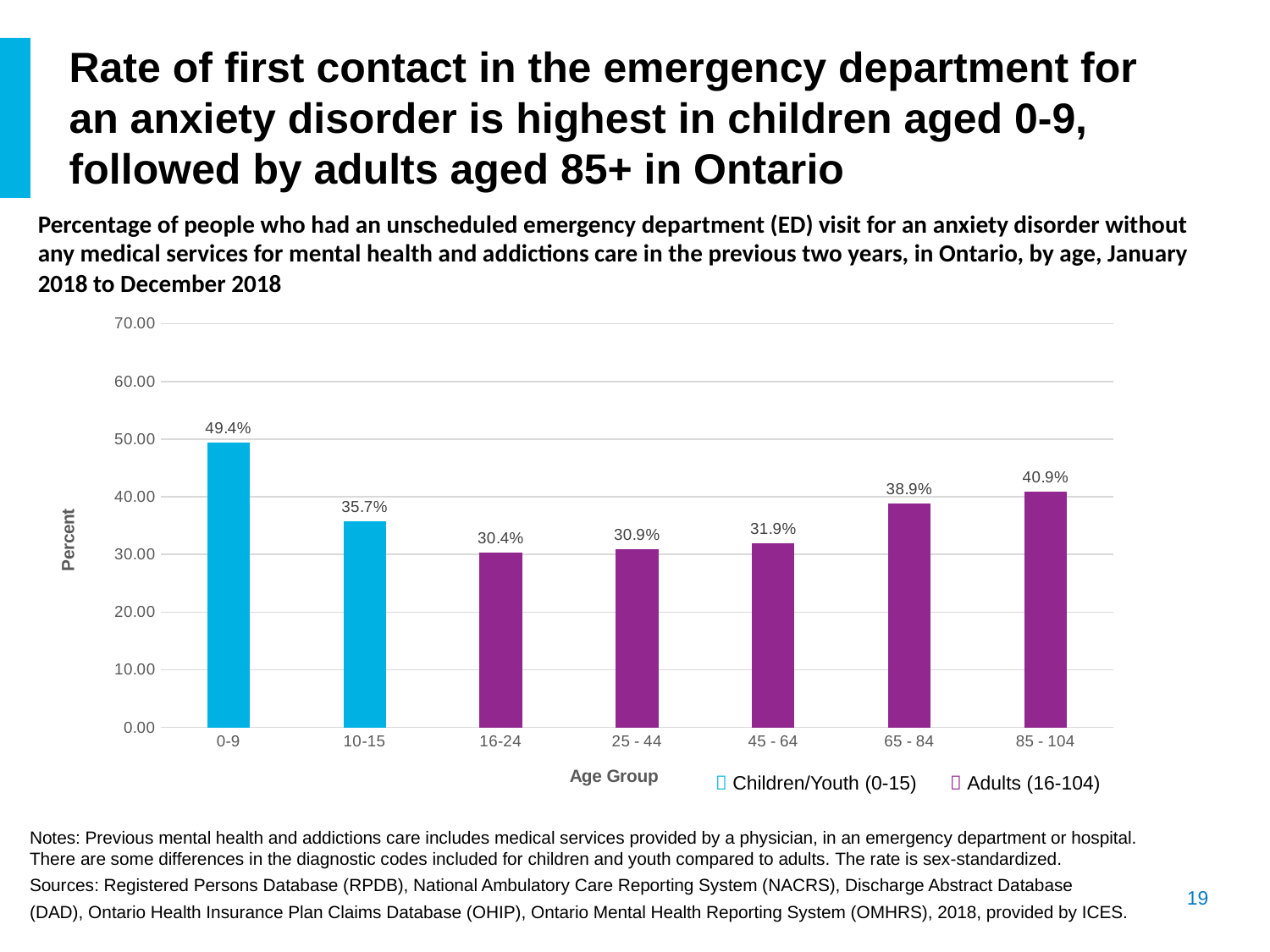
What is the difference between the values for the 0-9 and 85 - 104 age groups? 8.5 percentage points Which age group has the lowest value? 16-24 What is the label of the y axis? Percent Which is larger, the value for 10-15 or the value for 45 - 64? 10-15 What is the value for the 65 - 84 age group? 38.9% How many series does the legend list? 2 What is the value for the 0-9 age group? 49.4% Which age group has the highest value? 0-9 How many age groups are shown on the x axis? 7 What kind of chart is shown on the slide? Bar chart What is the value for the 16-24 age group? 30.4% Is the value for the 85 - 104 age group greater or less than 40.00? greater